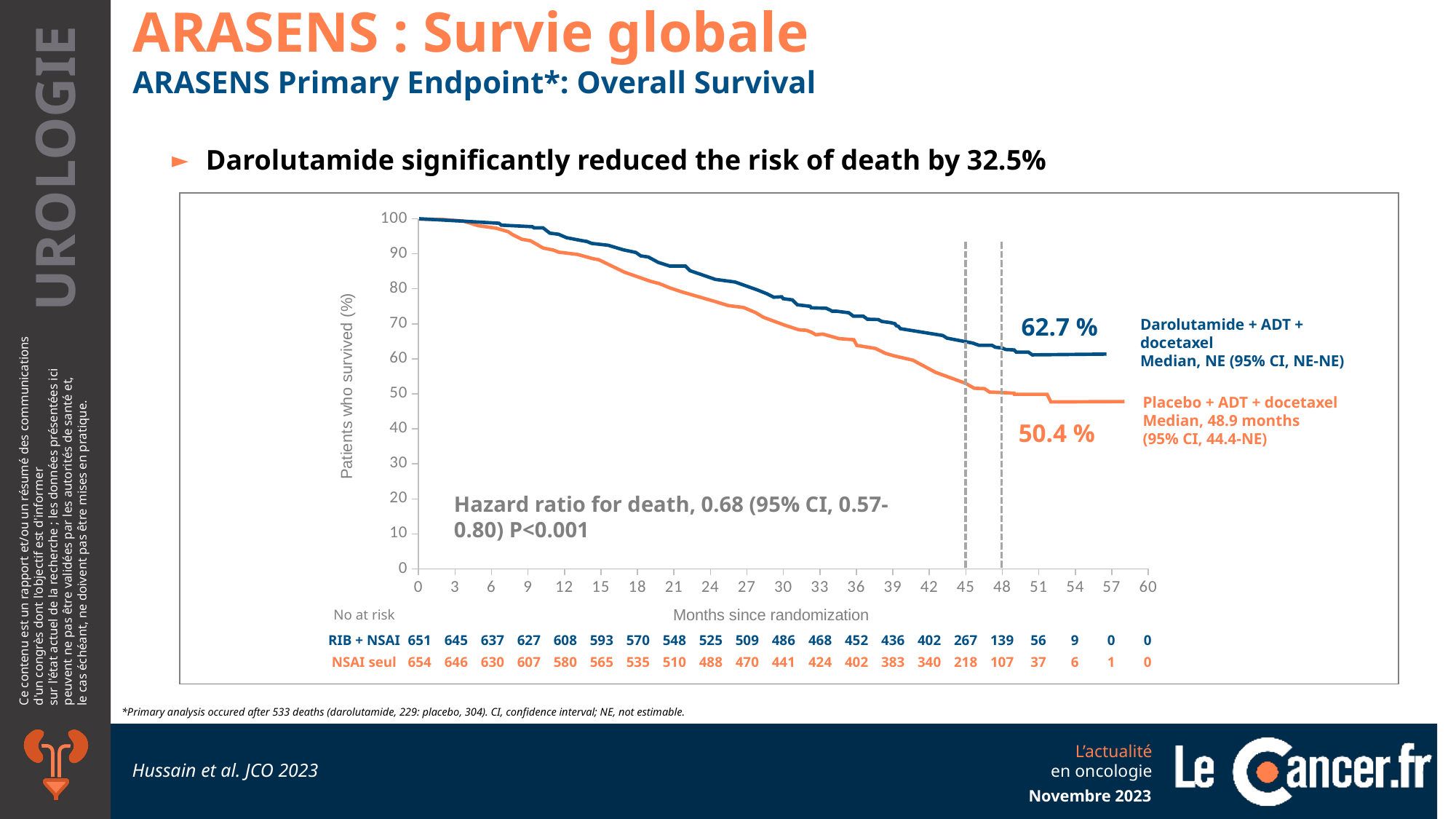
How many series (treatment arms) are plotted on the chart? 2 What survival percentage is labelled for the Placebo + ADT + docetaxel arm at the dashed line? 50.4 % What kind of chart is shown on the slide? line chart What is the difference between the labelled survival percentages of the darolutamide arm (62.7 %) and the placebo arm (50.4 %)? 12.3 percentage points What is the difference in number at risk at 45 months between the RIB + NSAI row (267) and the NSAI seul row (218)? 49 What survival percentage is labelled for the Darolutamide + ADT + docetaxel arm at the dashed line? 62.7 % Which arm has the higher labelled survival percentage, Darolutamide + ADT + docetaxel or Placebo + ADT + docetaxel? Darolutamide + ADT + docetaxel Do the survival curves rise or fall as months since randomization increase? fall What is the median overall survival reported for the Placebo + ADT + docetaxel arm? 48.9 months What hazard ratio for death is printed on the chart? 0.68 (95% CI, 0.57-0.80) In the number-at-risk table, how many patients are at risk in the NSAI seul row at 45 months? 218 Is the value of the Placebo + ADT + docetaxel curve at 30 months greater or less than 80? less